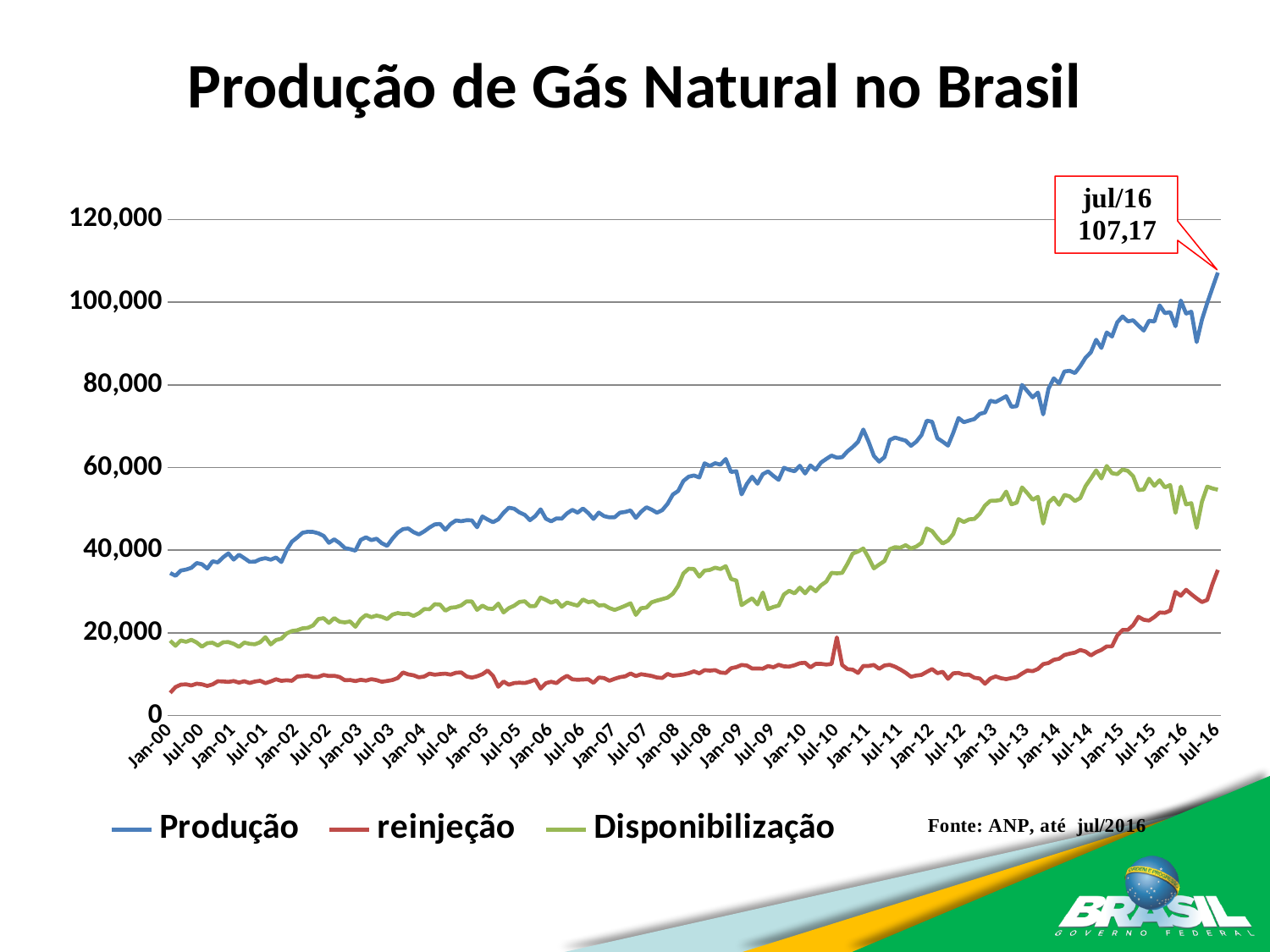
What value does the annotation give for Produção in jul/16? 107,17 What kind of chart is shown on the slide? line chart What is the title of the chart? Produção de Gás Natural no Brasil At Jul-16, which is larger: Produção or reinjeção? Produção Is the value for Produção at Jan-00 greater or less than 40,000? less Which series has the lowest values across the chart? reinjeção Is the value for reinjeção at Jan-00 greater or less than 20,000? less Is the value for Produção at Jan-15 greater or less than 80,000? greater Which series has the highest values across the chart? Produção How many series does the legend list? 3 Does the Produção series generally rise or fall from Jan-00 to Jul-16? rise